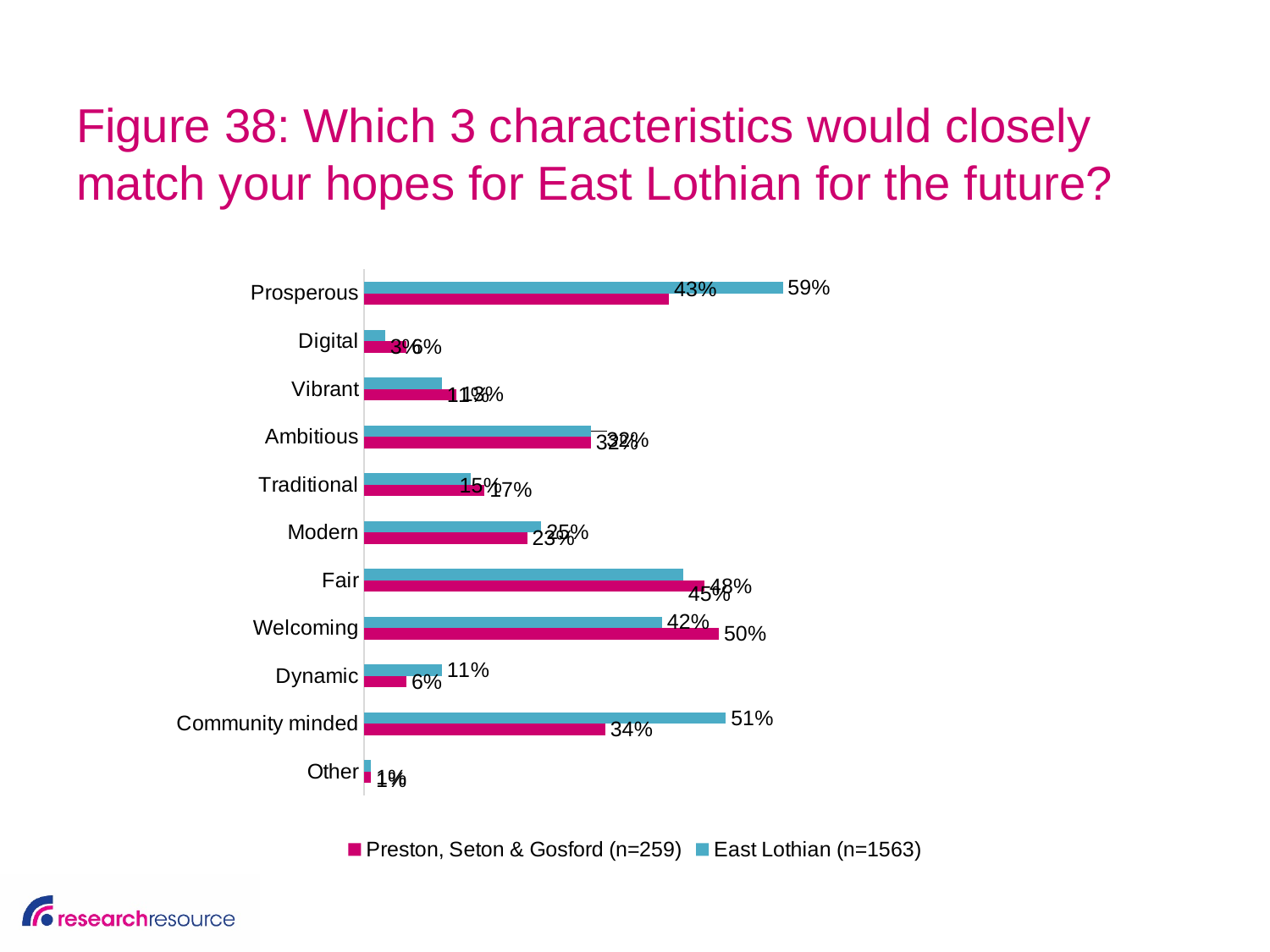
Which characteristic has the highest value for East Lothian? Prosperous How many series does the legend list? 2 What percentage of Preston, Seton & Gosford respondents chose Community minded? 34% Which characteristic has the lowest value for East Lothian? Other What is the value for Welcoming in the Preston, Seton & Gosford series? 50% Which characteristic has the highest value for Preston, Seton & Gosford? Welcoming What type of chart is shown on the slide? Bar chart For Welcoming, which series has the larger value? Preston, Seton & Gosford (n=259) What is the difference between the East Lothian and Preston, Seton & Gosford values for Community minded? 17 percentage points What percentage of East Lothian respondents chose Prosperous? 59% What is the value for Dynamic in the East Lothian series? 11% How many characteristics are listed on the chart? 11